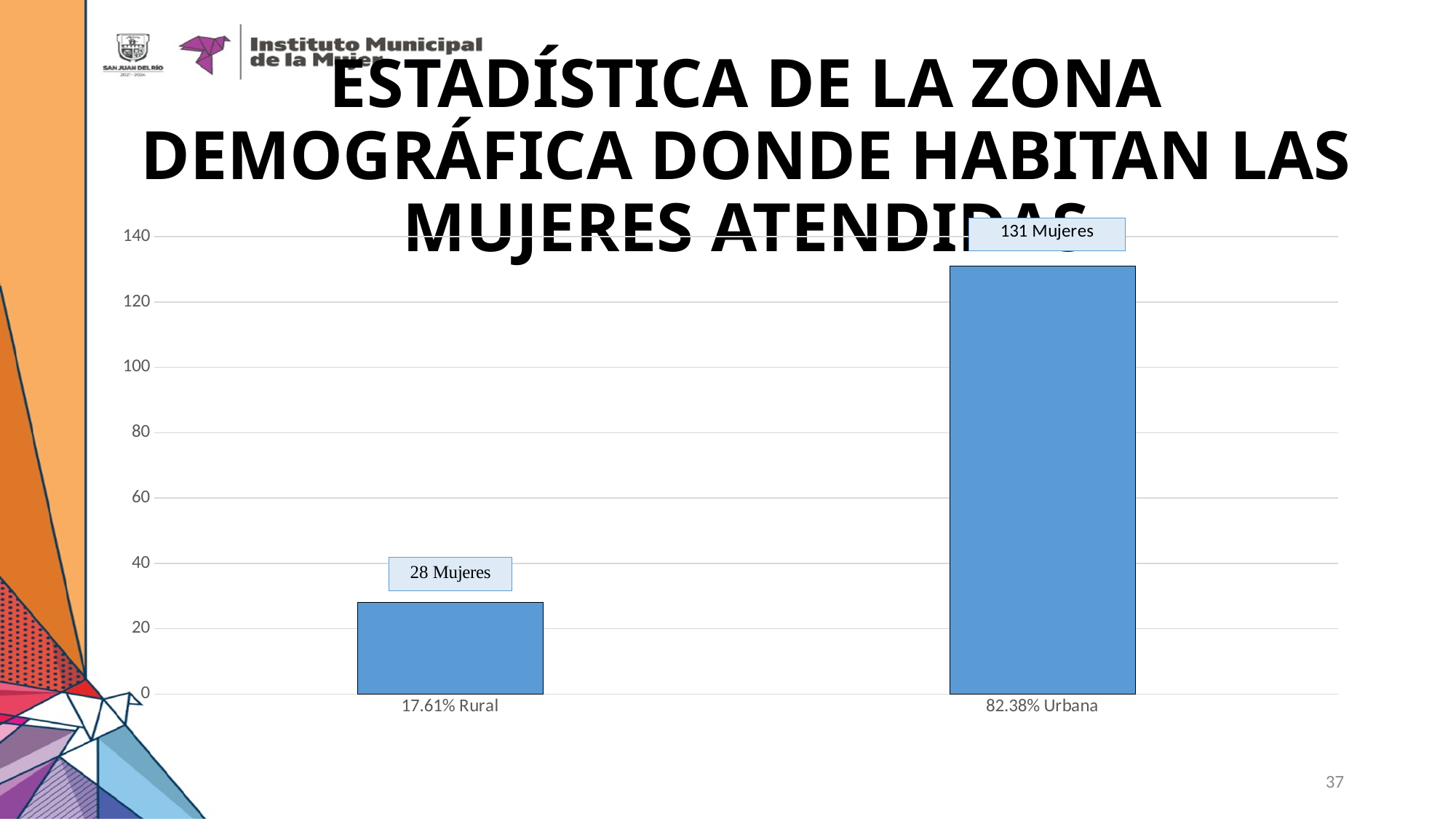
Is the value for Urbana greater or less than 120? greater What kind of chart is shown on the slide? bar chart How many women are shown for the Urbana category? 131 Mujeres How many women are shown for the Rural category? 28 Mujeres Which category has the lowest value? 17.61% Rural What percentage is shown in the x-axis label for the Rural category? 17.61% Which category has the highest value? 82.38% Urbana Is the value for Rural greater or less than 40? less What is the difference between the Urbana and Rural values? 103 Which is larger, the value for Rural or the value for Urbana? Urbana How many categories are shown on the x axis? 2 What is the highest value shown on the y axis? 140